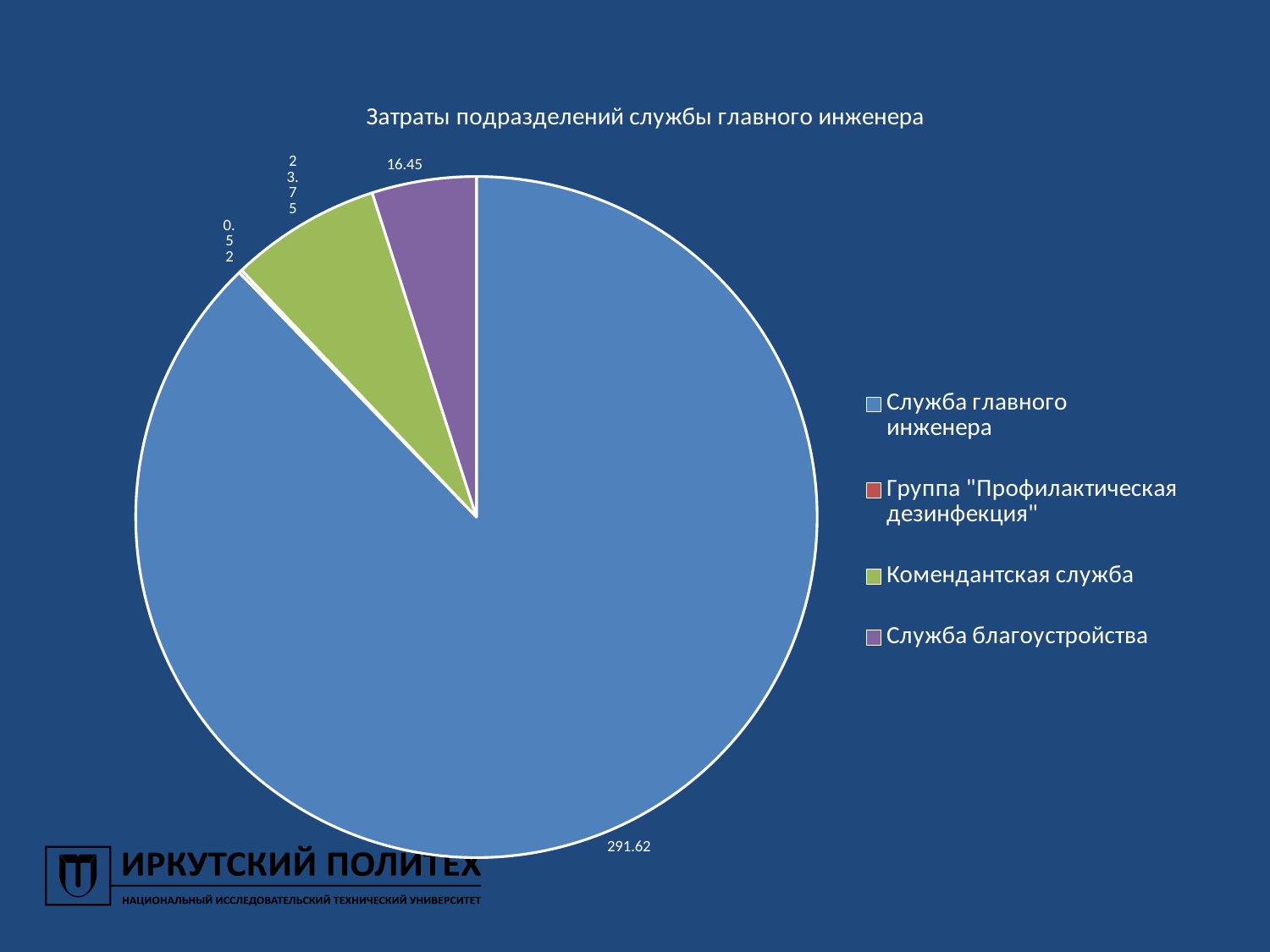
What is the value for Служба благоустройства? 16.45 How many slices does the pie chart have? 4 What is the title of the chart? Затраты подразделений службы главного инженера What colour is the slice for Комендантская служба? green Which is larger, the value for Комендантская служба or the value for Служба благоустройства? Комендантская служба What is the difference between the values for Комендантская служба and Служба благоустройства? 7.30 Which category has the smallest slice of the pie? Группа "Профилактическая дезинфекция" What is the value for Служба главного инженера? 291.62 What is the value for Группа "Профилактическая дезинфекция"? 0.52 Which category has the largest slice of the pie? Служба главного инженера What is the value for Комендантская служба? 23.75 What kind of chart is shown on the slide? pie chart